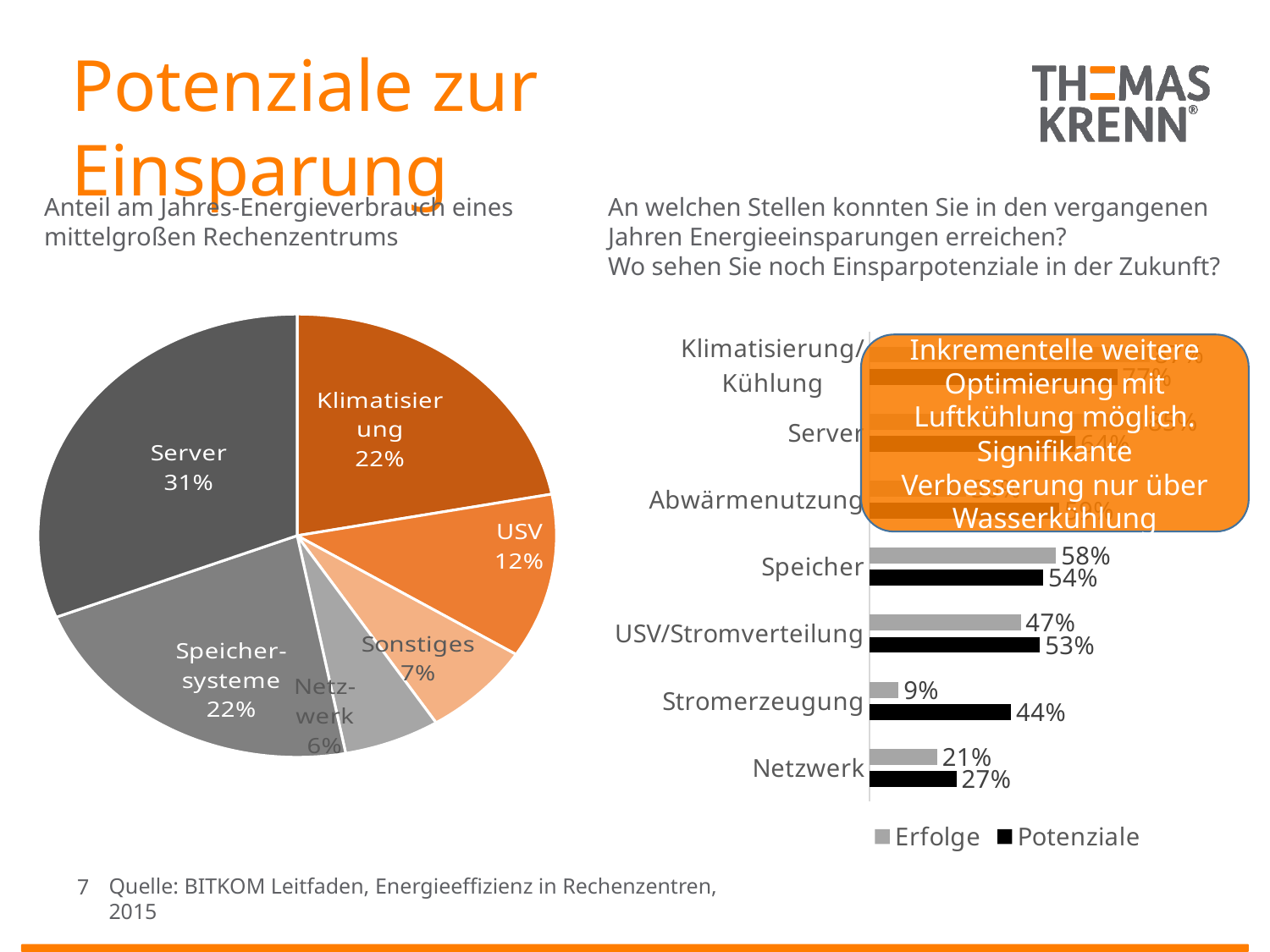
What type of chart is shown on the right side of the slide? Bar chart In the pie chart on the left, what share does Server have? 31% In the pie chart on the left, what is the share for USV? 12% In the bar chart on the right, what is the Erfolge value for Speicher? 58% In the pie chart on the left, which category has the smallest slice? Netzwerk In the bar chart on the right, what is the difference between the Potenziale and Erfolge values for Netzwerk? 6% In the bar chart on the right, how many series does the legend list? 2 In the bar chart on the right, which is larger for USV/Stromverteilung: Erfolge or Potenziale? Potenziale In the pie chart on the left, which category has the largest slice? Server In the pie chart on the left, what is the difference between the Server share and the Sonstiges share? 24% In the bar chart on the right, what is the Potenziale value for Stromerzeugung? 44% In the pie chart on the left, how many slices are there? 6